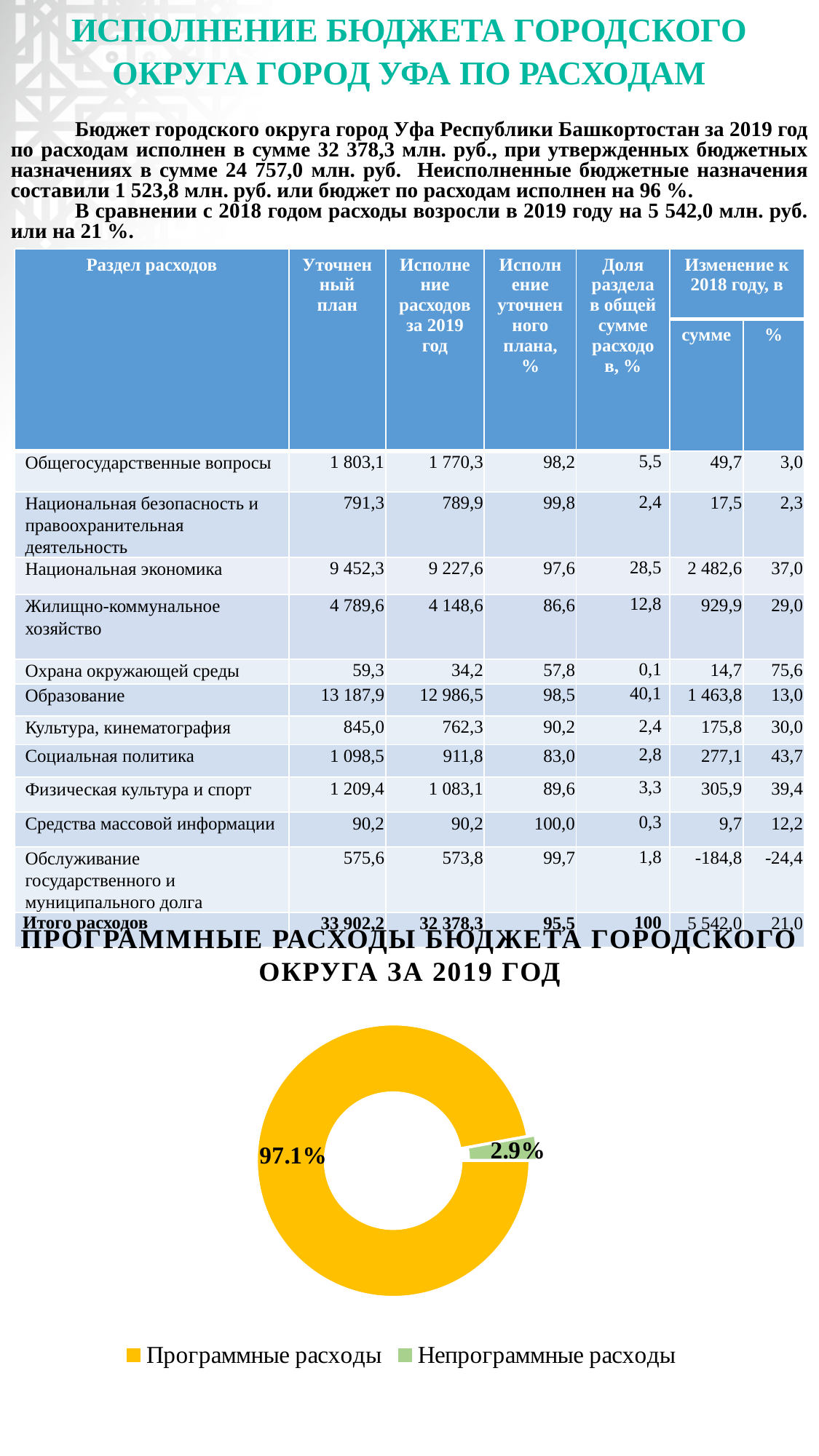
What is the title of the chart below the table? ПРОГРАММНЫЕ РАСХОДЫ БЮДЖЕТА ГОРОДСКОГО ОКРУГА ЗА 2019 ГОД Which category has the largest slice in the doughnut chart? Программные расходы What type of chart is shown below the table? Doughnut (pie) chart What share of the doughnut chart is labelled 'Непрограммные расходы'? 2.9% By how many percentage points does the 'Программные расходы' slice exceed the 'Непрограммные расходы' slice? 94.2 Which is larger in the doughnut chart: 'Программные расходы' or 'Непрограммные расходы'? Программные расходы Which category has the smallest slice in the doughnut chart? Непрограммные расходы What share of the doughnut chart is labelled 'Программные расходы'? 97.1% What colour is the 'Непрограммные расходы' slice in the doughnut chart? Green How many entries does the legend of the doughnut chart list? 2 How many slices does the doughnut chart have? 2